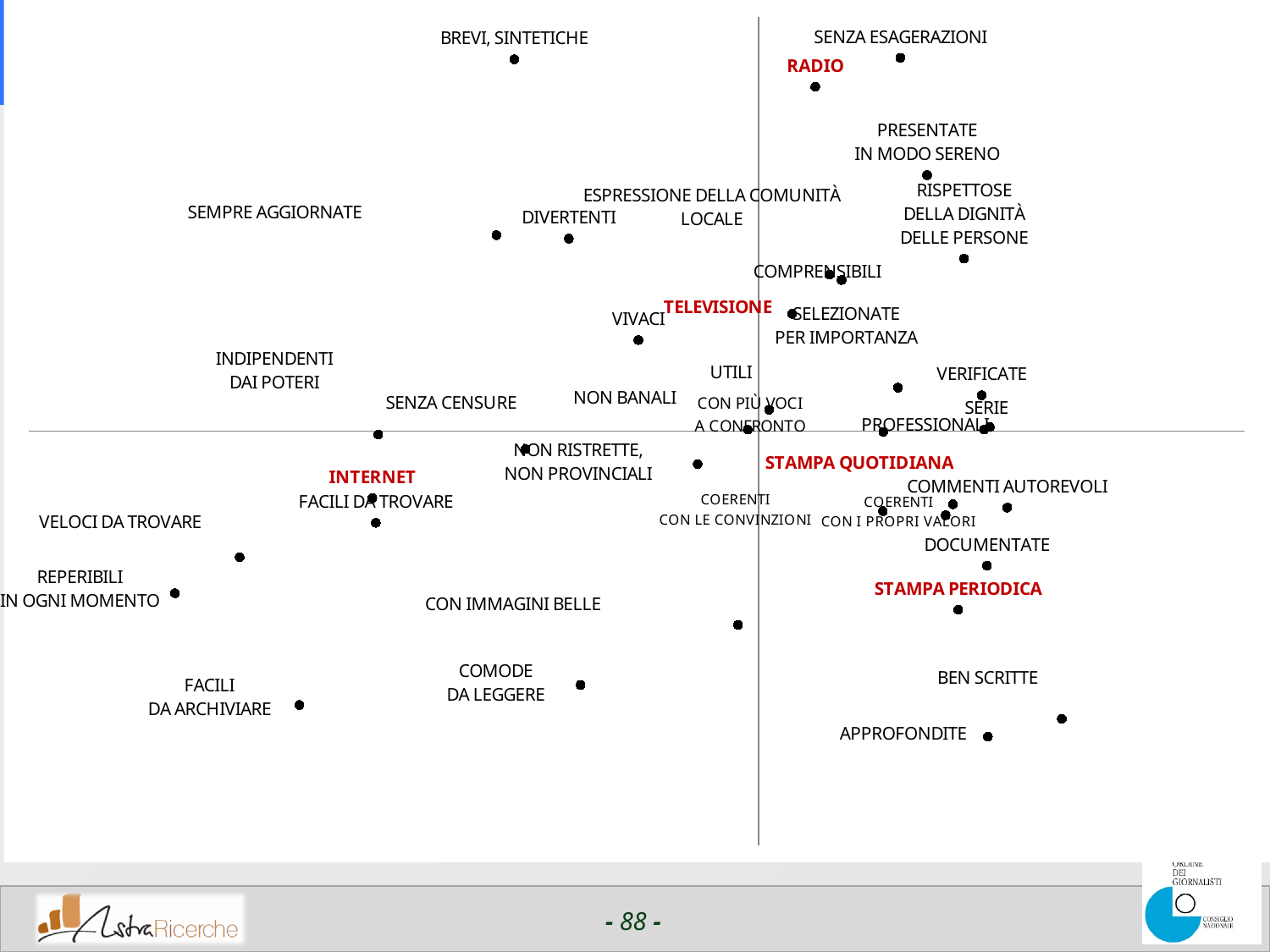
Which media label is positioned lowest on the chart? STAMPA PERIODICA Is the INTERNET point to the left or to the right of the vertical axis? left Which attribute label appears in the top-left area of the chart, near the top? BREVI, SINTETICHE Which is positioned further to the left on the chart, INTERNET or RADIO? INTERNET Which media label is closest to the attribute 'VIVACI'? TELEVISIONE Which media label is positioned highest on the chart? RADIO Which media label is positioned furthest to the left on the chart? INTERNET Which is positioned higher on the chart, TELEVISIONE or STAMPA QUOTIDIANA? TELEVISIONE How many media types are labelled in red on the chart? 5 What kind of chart is shown on the slide? scatter chart